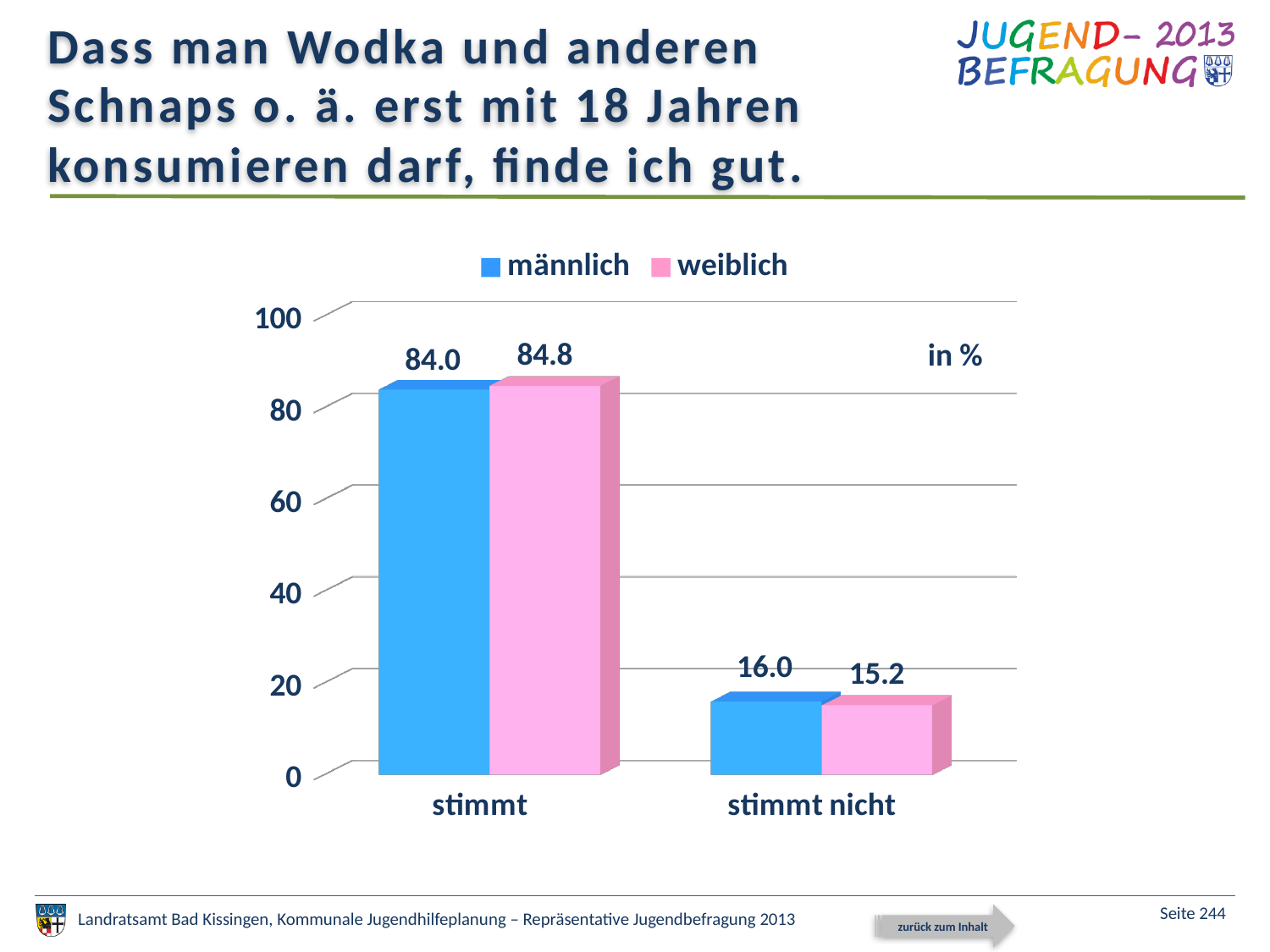
Which category has the highest value for weiblich? stimmt What is the difference between the männlich and weiblich values in the stimmt nicht category? 0.8 What is the value for männlich in the stimmt nicht category? 16.0 What is the value for weiblich in the stimmt category? 84.8 Is the männlich value for stimmt greater or less than 80? greater What is the value for weiblich in the stimmt nicht category? 15.2 Which category has the lowest value for männlich? stimmt nicht What is the value for männlich in the stimmt category? 84.0 What is the difference between the weiblich and männlich values in the stimmt category? 0.8 How many series does the legend list? 2 What kind of chart is shown on the slide? bar chart How many categories are shown on the x axis? 2